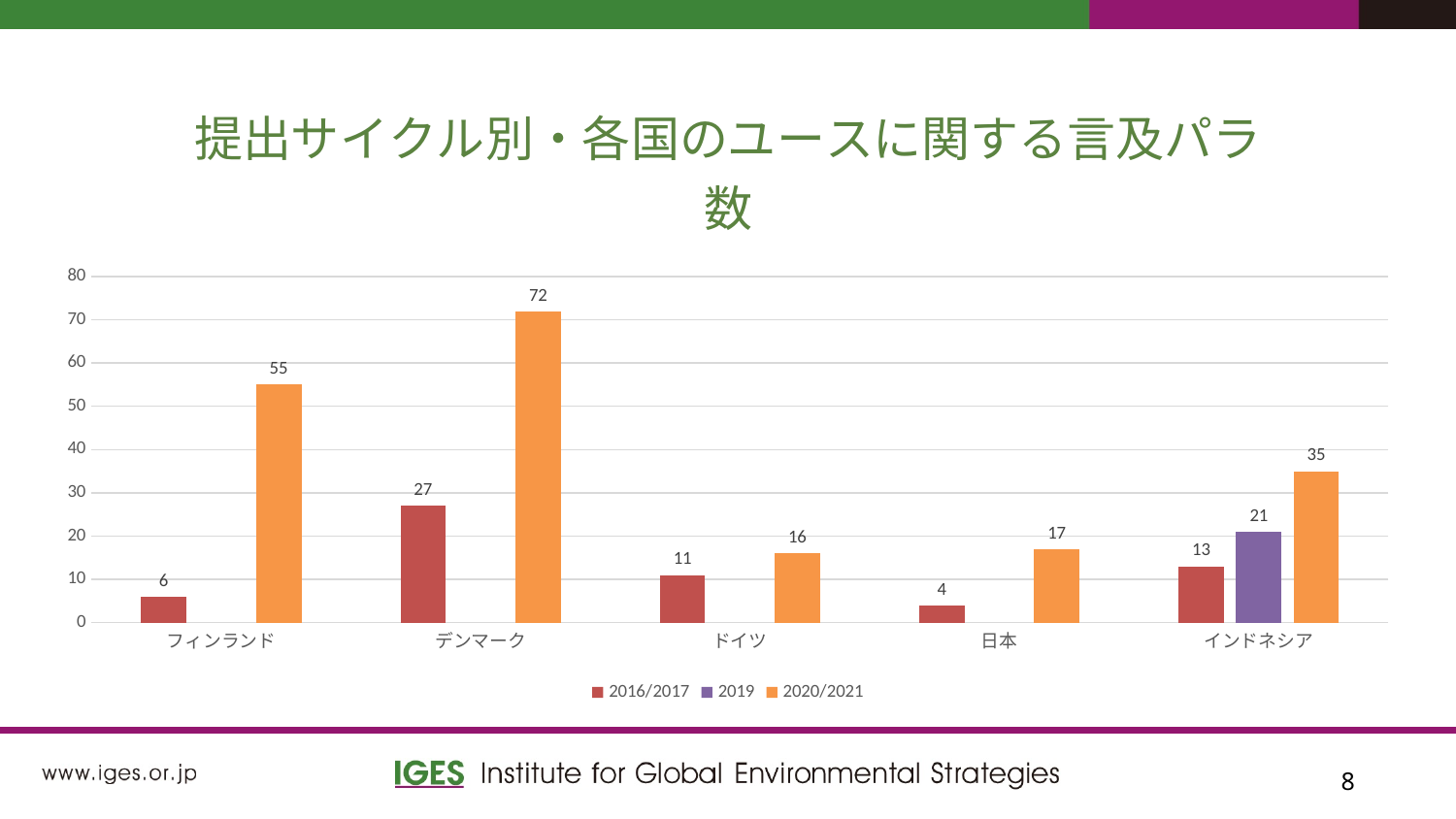
How many countries (categories) are shown on the x axis? 5 How many series does the legend list? 3 Which country has the lowest 2016/2017 value? 日本 What is the 2016/2017 value for 日本? 4 Which country is the only one with a bar for the 2019 series? インドネシア What is the 2020/2021 value for デンマーク? 72 What type of chart is shown on the slide? bar chart Which series is shown in orange in the legend? 2020/2021 What is the 2019 value for インドネシア? 21 What is the difference between the 2020/2021 and 2016/2017 values for フィンランド? 49 Which is larger: the 2020/2021 value for ドイツ or the 2020/2021 value for 日本? 日本 Which country has the highest 2020/2021 value? デンマーク